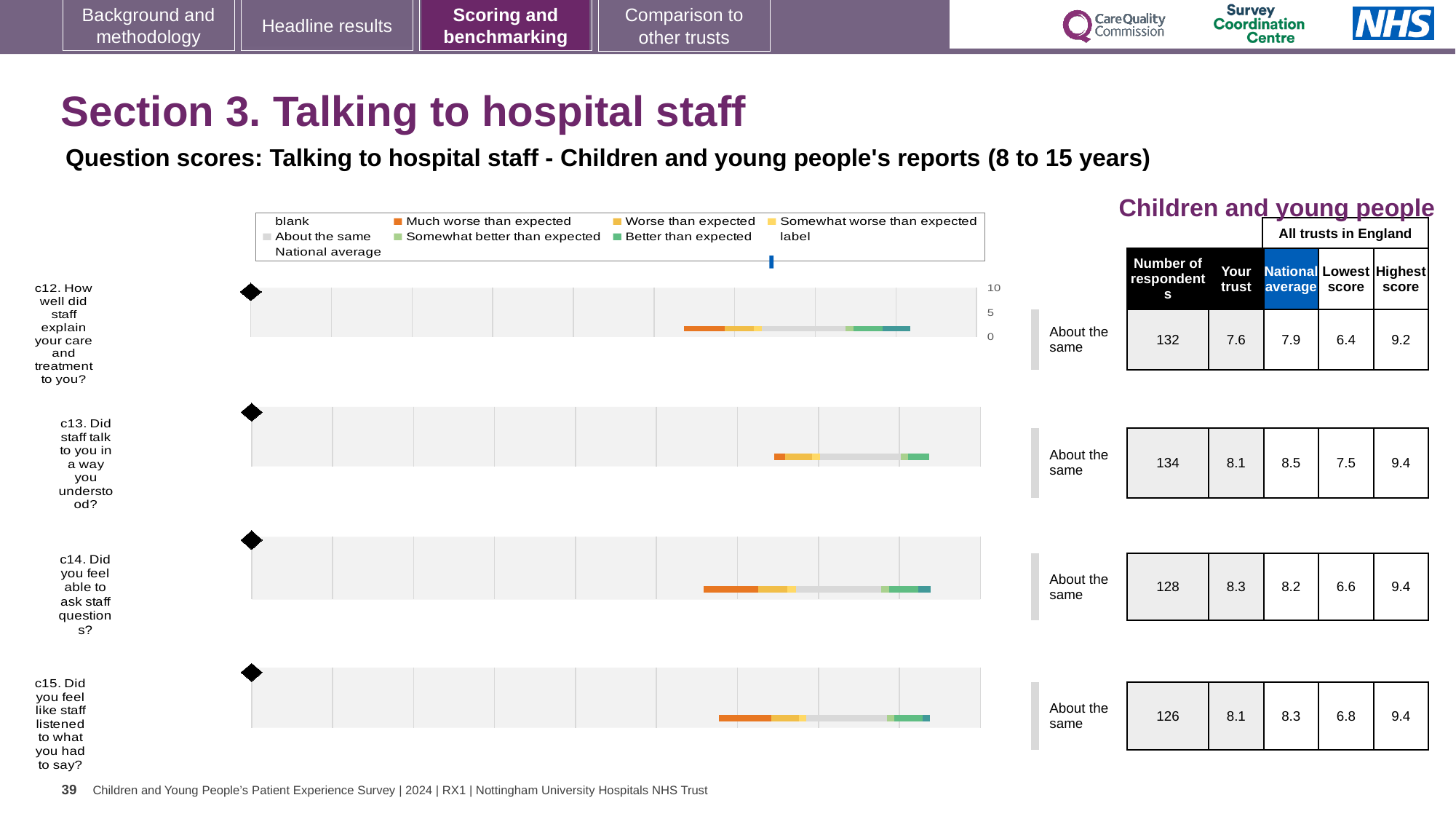
What is the lowest score among all trusts in England for c15 (Did you feel like staff listened to what you had to say)? 6.8 What is the national average score for c13 (Did staff talk to you in a way you understood)? 8.5 Which question has the lowest 'Your trust' score? c12 How many respondents answered question c12 (How well did staff explain your care and treatment to you)? 132 What is the highest score among all trusts in England for c12? 9.2 For c14, which is larger: the 'Your trust' score or the national average? Your trust What is the 'Your trust' score for c14 (Did you feel able to ask staff questions)? 8.3 Which question has the highest 'Your trust' score? c14 What benchmarking category is shown for all four questions on this slide? About the same What kind of chart is used to show the question scores on this slide? bar chart How many questions (c12 to c15) are plotted on the slide? 4 For c13, what is the difference between the national average and the 'Your trust' score? 0.4